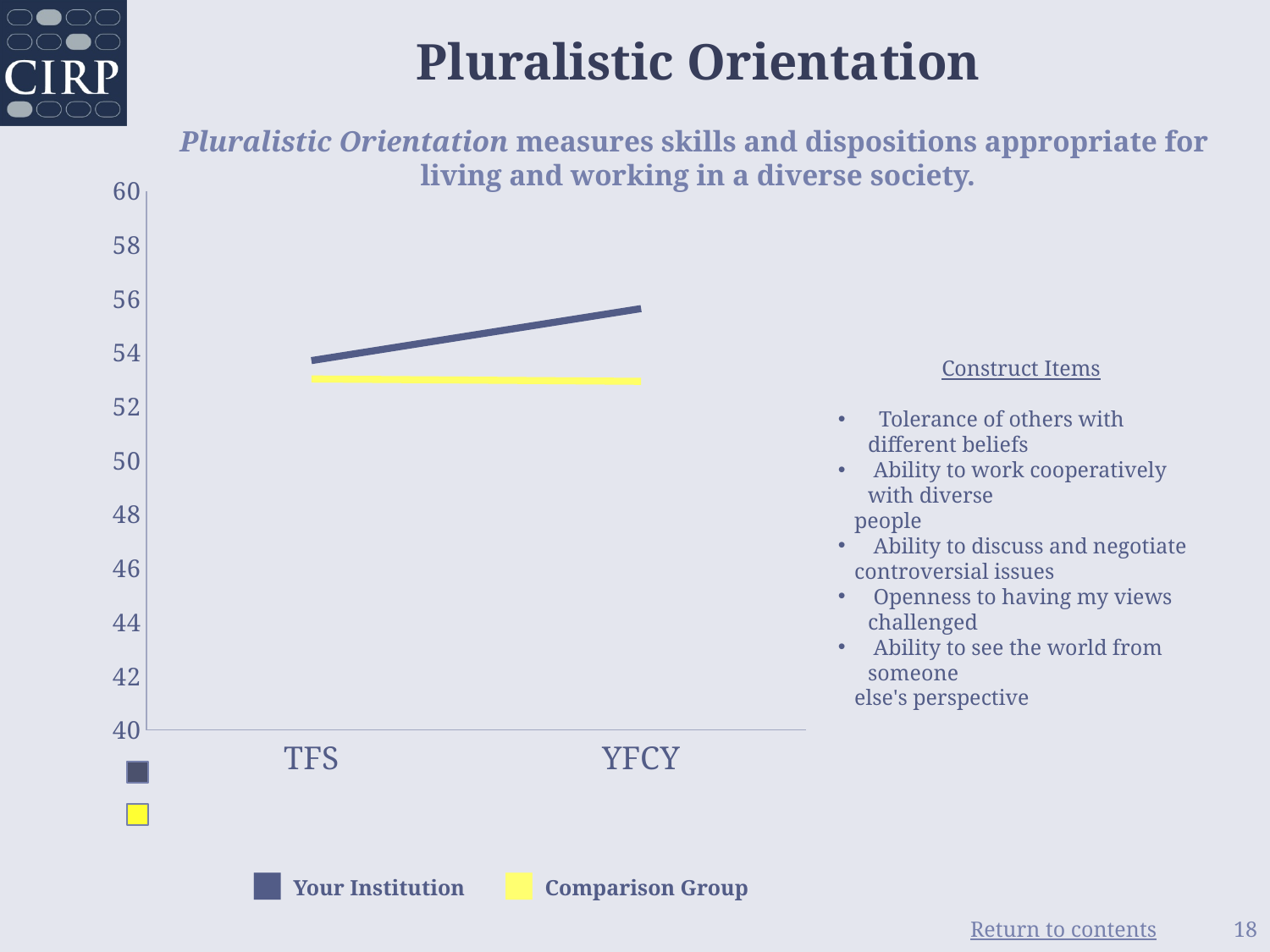
What is the highest value shown on the y axis? 60 How many series does the legend list? 2 Which series is drawn in yellow? Comparison Group Is the value for Your Institution at YFCY greater or less than 54? greater How many categories are shown on the x axis? 2 Is the value for Comparison Group at YFCY greater or less than 56? less What kind of chart is shown on the slide? line chart Does the Your Institution line rise or fall from TFS to YFCY? rise What are the two categories on the x axis? TFS and YFCY Is the value for Your Institution at TFS greater or less than 52? greater At YFCY, which series has the higher value, Your Institution or Comparison Group? Your Institution